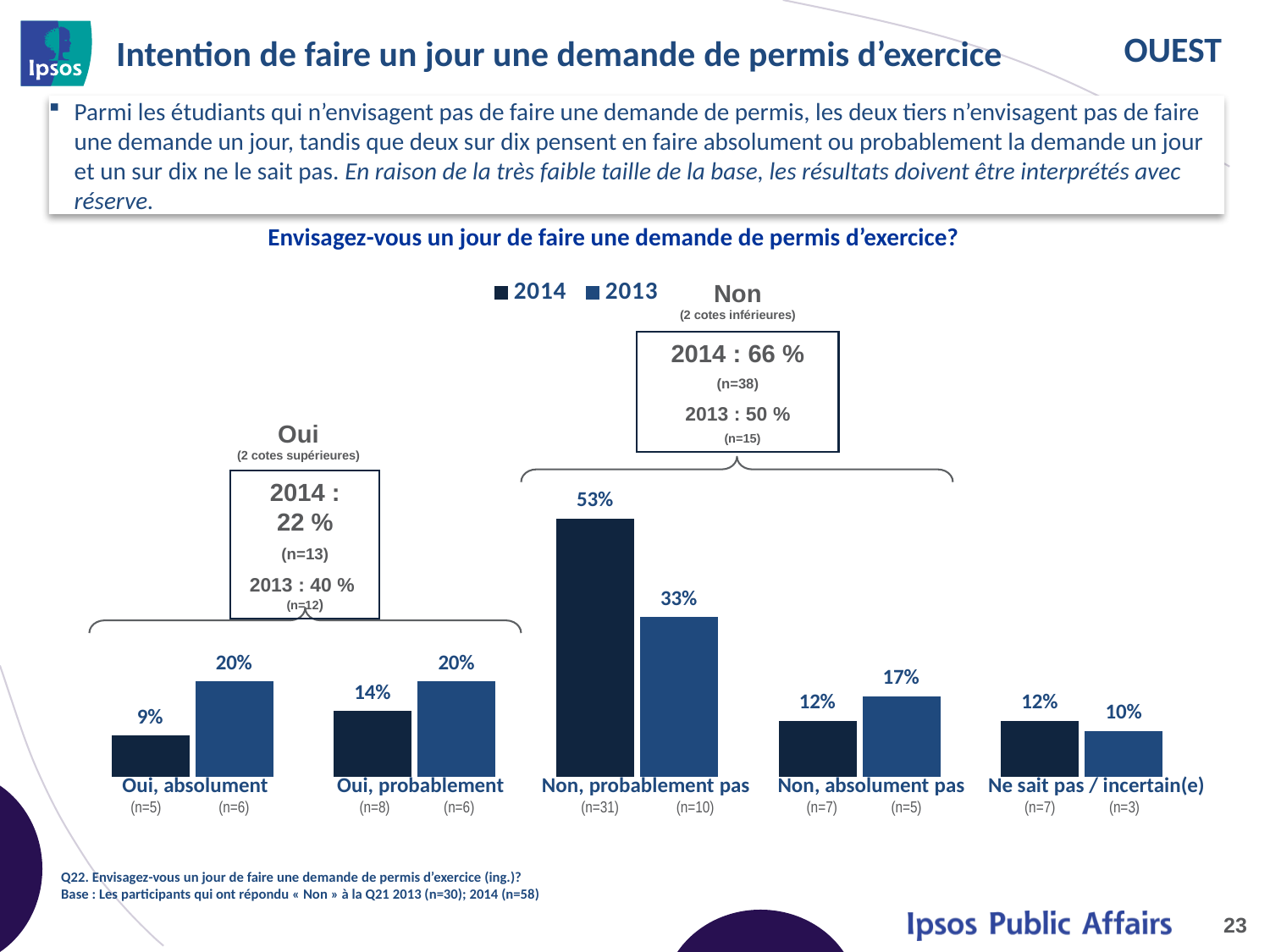
What is the question shown as the chart title? Envisagez-vous un jour de faire une demande de permis d’exercice? Which category has the highest 2014 value? Non, probablement pas What is the 2013 value for "Ne sait pas / incertain(e)"? 10% What is the difference between the 2014 and 2013 values for "Non, probablement pas"? 20 percentage points What is the 2014 value for "Non, probablement pas"? 53% What is the 2013 value for "Oui, absolument"? 20% How many series does the legend list? 2 For "Non, absolument pas", which year has the larger value, 2014 or 2013? 2013 How many categories are shown on the x axis? 5 What is the 2014 value for "Oui, probablement"? 14% What kind of chart is shown on the slide? Bar chart Which category has the lowest 2014 value? Oui, absolument